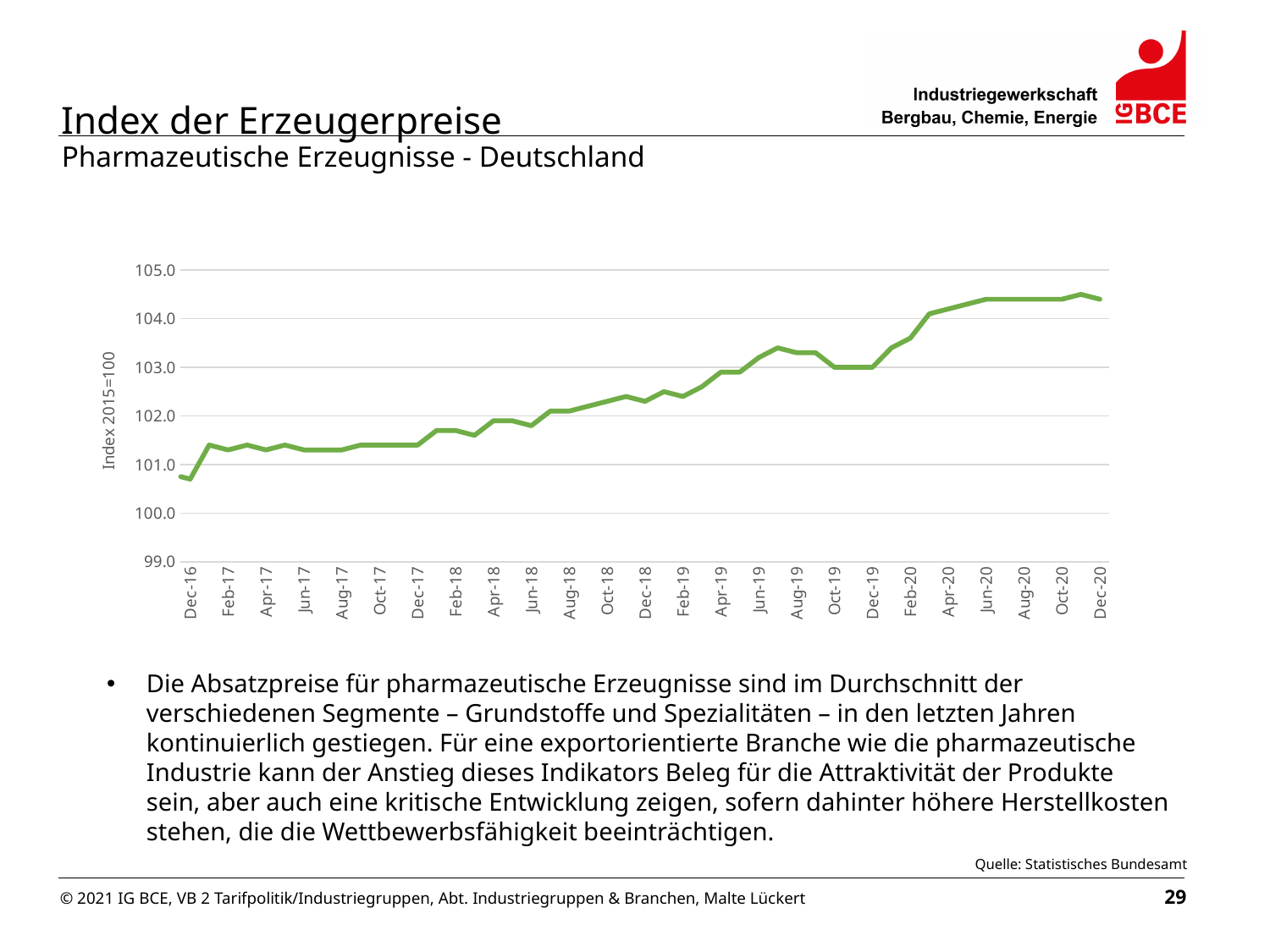
Do the values generally rise or fall from Dec-16 to Dec-20? rise Which month on the x axis has the lowest value? Dec-16 Is the value for Dec-16 greater or less than 101.0? less What is the label on the y axis? Index 2015=100 Which is larger, the value for Dec-20 or the value for Dec-16? Dec-20 Is the value for Jun-20 greater or less than 104.0? greater Is the value for Jun-17 greater or less than 102.0? less What kind of chart is shown on the slide? line chart How many month labels are shown on the x axis? 25 What colour is the line in the chart? green